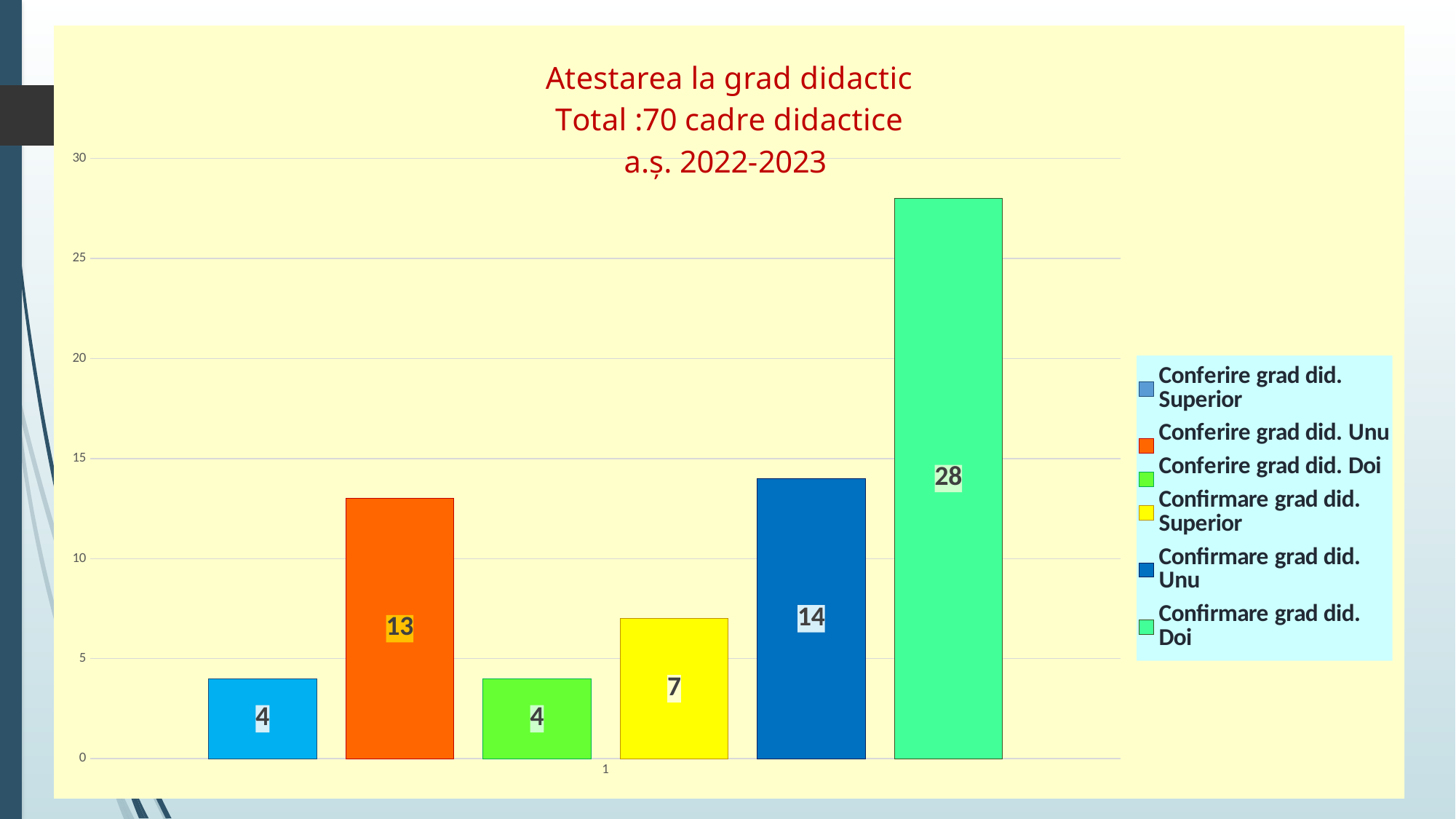
Which is larger, Conferire grad did. Unu or Confirmare grad did. Unu? Confirmare grad did. Unu What is the difference between Conferire grad did. Unu and Confirmare grad did. Superior? 6 What kind of chart is shown on the slide? Bar chart What value is shown for Confirmare grad did. Unu? 14 What value is shown for Confirmare grad did. Superior? 7 What value is shown for Confirmare grad did. Doi? 28 What is the total of all the bars shown in the chart? 70 Which series has the highest value? Confirmare grad did. Doi How many series does the legend list? 6 What value is shown for Conferire grad did. Unu? 13 What is the difference between Confirmare grad did. Doi and Confirmare grad did. Unu? 14 What is the title of the chart? Atestarea la grad didactic Total :70 cadre didactice a.ș. 2022-2023